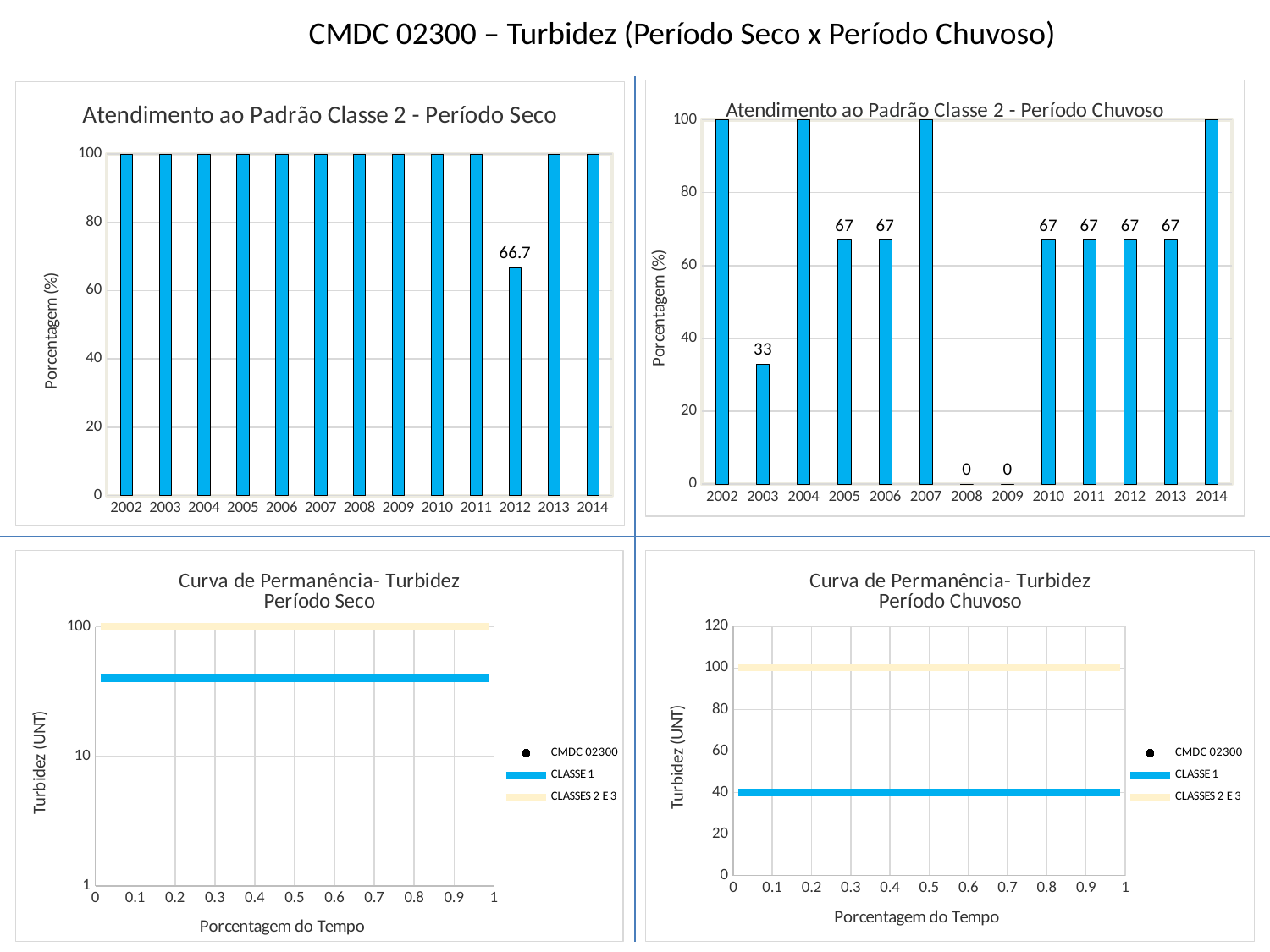
In the 'Atendimento ao Padrão Classe 2 - Período Chuvoso' chart, what is the value for 2003? 33 In the 'Curva de Permanência- Turbidez Período Seco' chart, how many series does the legend list? 3 What kind of chart is 'Atendimento ao Padrão Classe 2 - Período Chuvoso'? bar chart In the 'Curva de Permanência- Turbidez Período Chuvoso' chart, at what Turbidez value is the CLASSES 2 E 3 line drawn? 100 In the 'Atendimento ao Padrão Classe 2 - Período Seco' chart, what is the value for 2012? 66.7 In the 'Atendimento ao Padrão Classe 2 - Período Chuvoso' chart, what is the difference between the values for 2005 and 2003? 34 In the 'Atendimento ao Padrão Classe 2 - Período Chuvoso' chart, which is larger, the value for 2004 or the value for 2005? 2004 In the 'Atendimento ao Padrão Classe 2 - Período Seco' chart, how many years are shown on the x axis? 13 In the 'Atendimento ao Padrão Classe 2 - Período Chuvoso' chart, what is the value for 2008? 0 What is the y-axis title of the 'Curva de Permanência- Turbidez Período Seco' chart? Turbidez (UNT) In the 'Atendimento ao Padrão Classe 2 - Período Seco' chart, which year has the lowest value? 2012 In the 'Atendimento ao Padrão Classe 2 - Período Chuvoso' chart, is the value for 2010 greater or less than 60? greater